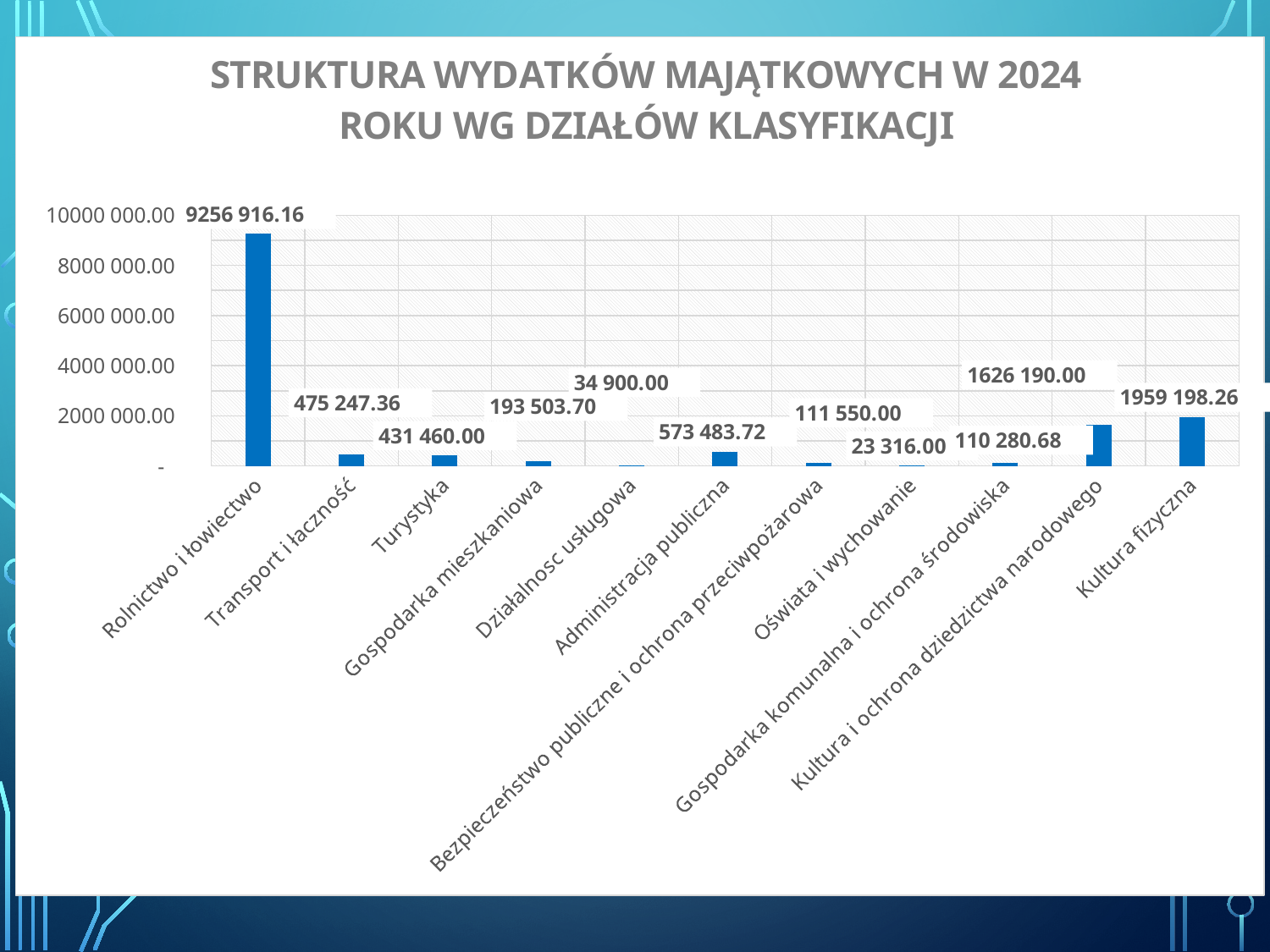
Which category has the highest value? Rolnictwo i łowiectwo How many categories are shown on the x axis? 11 Is the value for Rolnictwo i łowiectwo greater or less than 8000 000.00? greater Which is larger, the value for Administracja publiczna or the value for Transport i łączność? Administracja publiczna What is the difference between the values for Kultura fizyczna and Kultura i ochrona dziedzictwa narodowego? 333 008.26 What is the value for Administracja publiczna? 573 483.72 Which category has the lowest value? Oświata i wychowanie What kind of chart is shown on the slide? bar chart What is the value for Oświata i wychowanie? 23 316.00 What is the value for Kultura fizyczna? 1959 198.26 What is the value for Rolnictwo i łowiectwo? 9256 916.16 What is the title of the chart? STRUKTURA WYDATKÓW MAJĄTKOWYCH W 2024 ROKU WG DZIAŁÓW KLASYFIKACJI